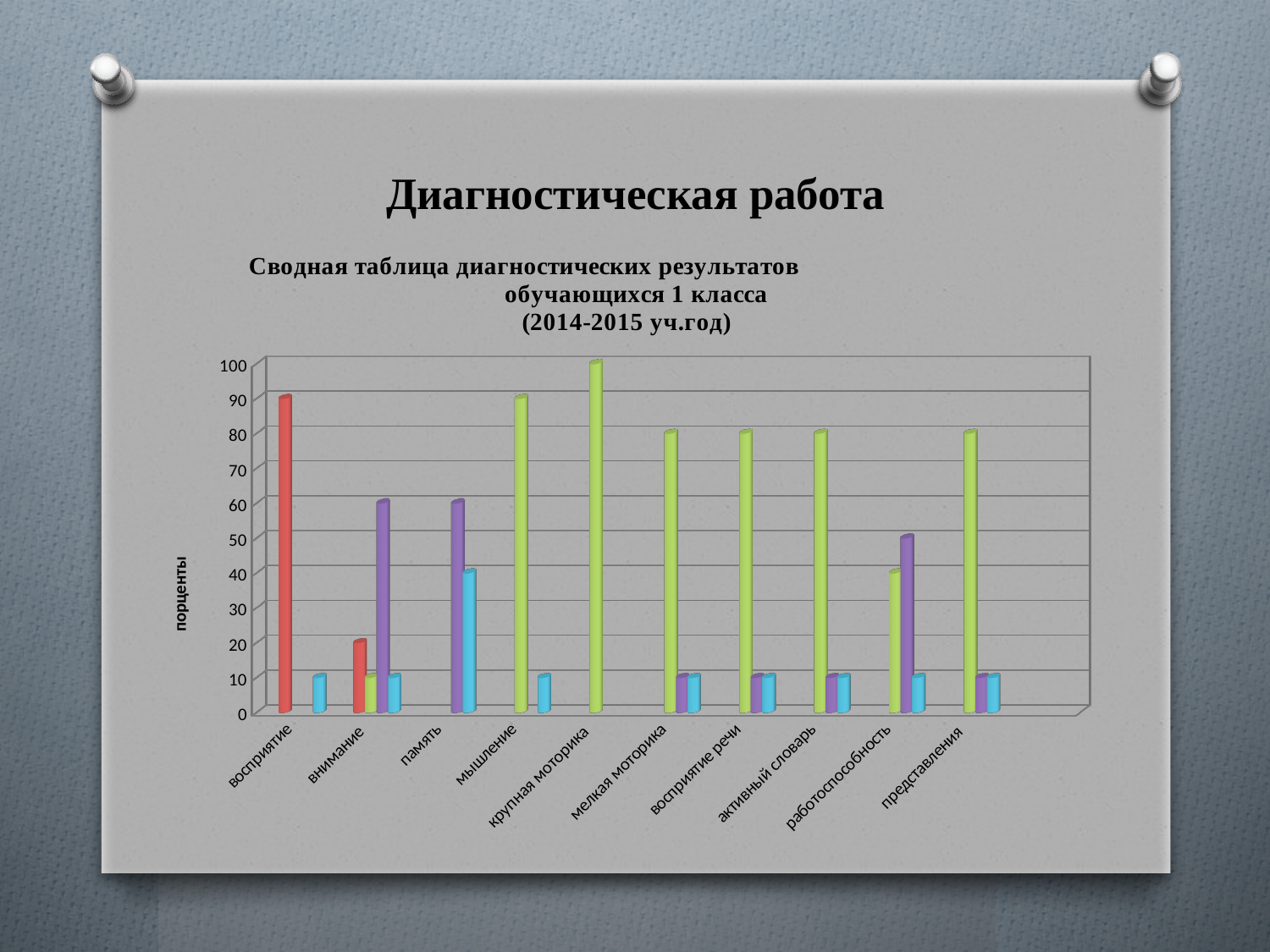
Is the value of the red bar for восприятие greater or less than 50? greater How many categories are shown along the x axis of the chart? 10 Is the value of the purple bar for мелкая моторика greater or less than 20? less Is the value of the green bar for работоспособность greater or less than 50? less What is the title of the chart? Сводная таблица диагностических результатов обучающихся 1 класса (2014-2015 уч.год) Which category has the tallest bar in the chart? крупная моторика What kind of chart is shown on the slide? bar chart What is the label on the vertical axis of the chart? порценты For внимание, which bar is taller: the purple bar or the red bar? the purple bar For работоспособность, which bar is taller: the purple bar or the green bar? the purple bar